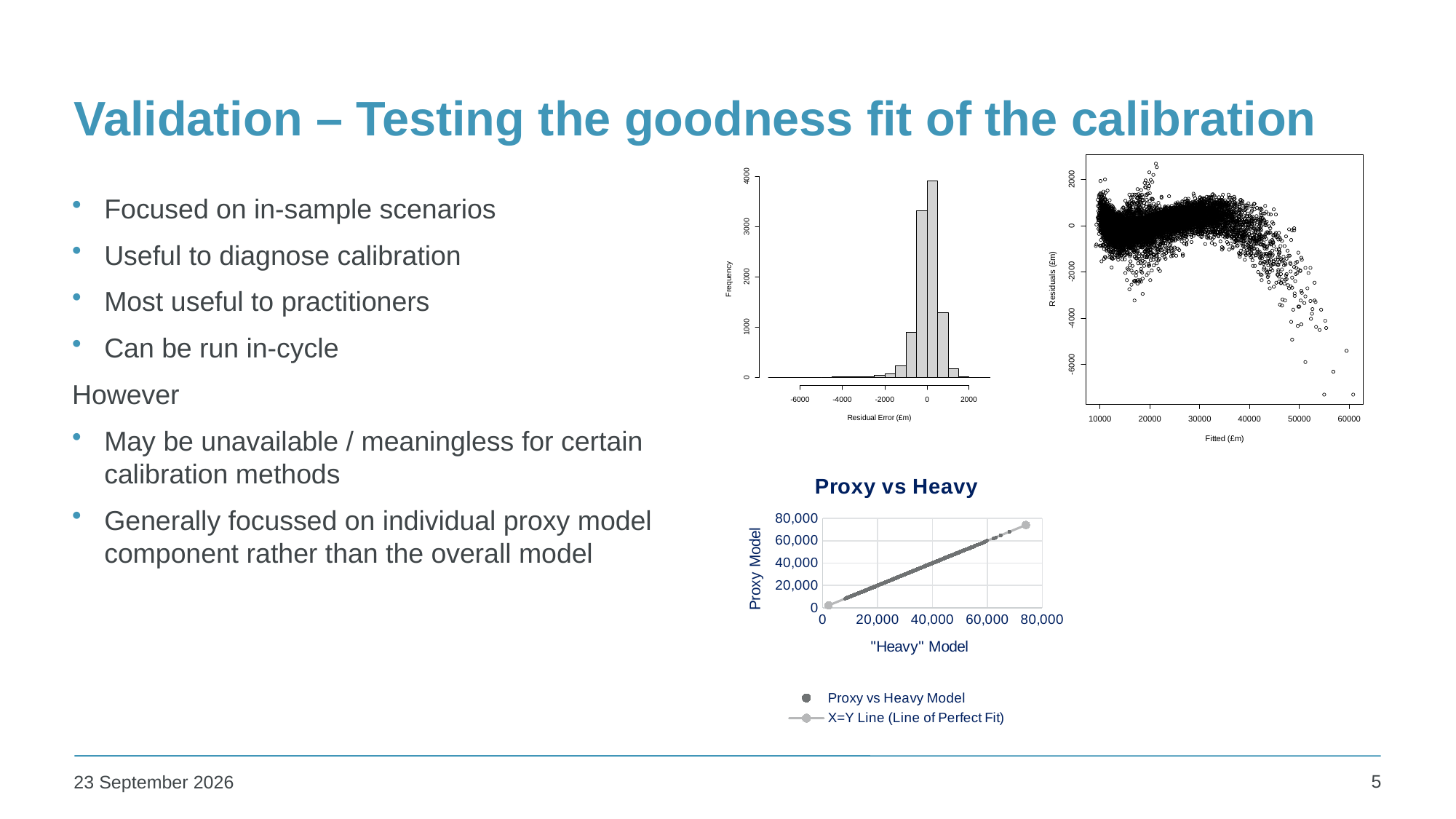
What kind of chart is the Proxy vs Heavy chart? Scatter chart In the top-left chart with Residual Error (£m) on the x axis, is the frequency of the tallest bar greater or less than 3000? greater What is the label of the y axis in the top-left chart with Residual Error (£m) on the x axis? Frequency What kind of chart is the top-left chart with Residual Error (£m) on the x axis? Bar chart In the Proxy vs Heavy chart, do the Proxy Model values rise or fall as the "Heavy" Model values increase along the x axis? Rise In the top-right chart with Fitted (£m) on the x axis, do the residuals generally rise or fall as the fitted values increase beyond 40000? Fall In the Proxy vs Heavy chart, how many series does the legend list? 2 What is the title of the chart at the bottom of the slide? Proxy vs Heavy What kind of chart is the top-right chart with Fitted (£m) on the x axis? Scatter chart What is the label of the x axis in the Proxy vs Heavy chart? "Heavy" Model